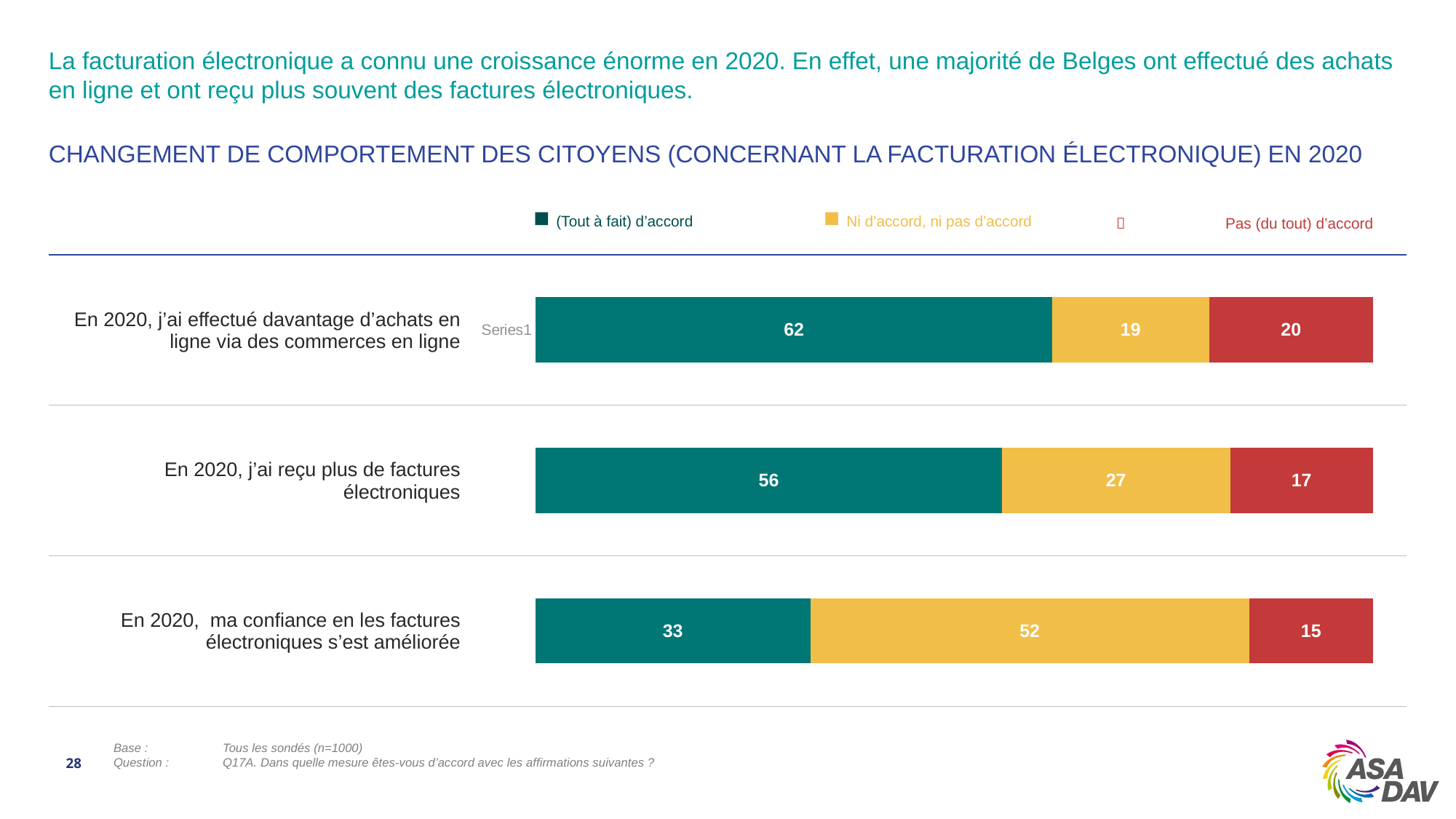
Which statement has the highest "(Tout à fait) d'accord" value? En 2020, j'ai effectué davantage d'achats en ligne via des commerces en ligne What is the value for "Pas (du tout) d'accord" for the statement "En 2020, ma confiance en les factures électroniques s'est améliorée"? 15 What is the difference between the "(Tout à fait) d'accord" values for the online purchases statement and the received more e-invoices statement? 6 What kind of chart is shown on the slide? Stacked bar chart What percentage of respondents (tout à fait) d'accord with "En 2020, j'ai effectué davantage d'achats en ligne via des commerces en ligne"? 62 What is the total of the stacked bar for "En 2020, j'ai reçu plus de factures électroniques"? 100 Which statement has the lowest "(Tout à fait) d'accord" value? En 2020, ma confiance en les factures électroniques s'est améliorée What is the value for "Ni d'accord, ni pas d'accord" for the statement "En 2020, j'ai reçu plus de factures électroniques"? 27 Which colour represents "Pas (du tout) d'accord" in the chart? Red For the statement about confidence in electronic invoices, which is larger: "(Tout à fait) d'accord" or "Ni d'accord, ni pas d'accord"? Ni d'accord, ni pas d'accord How many series does the legend list? 3 How many statements are shown in the chart? 3